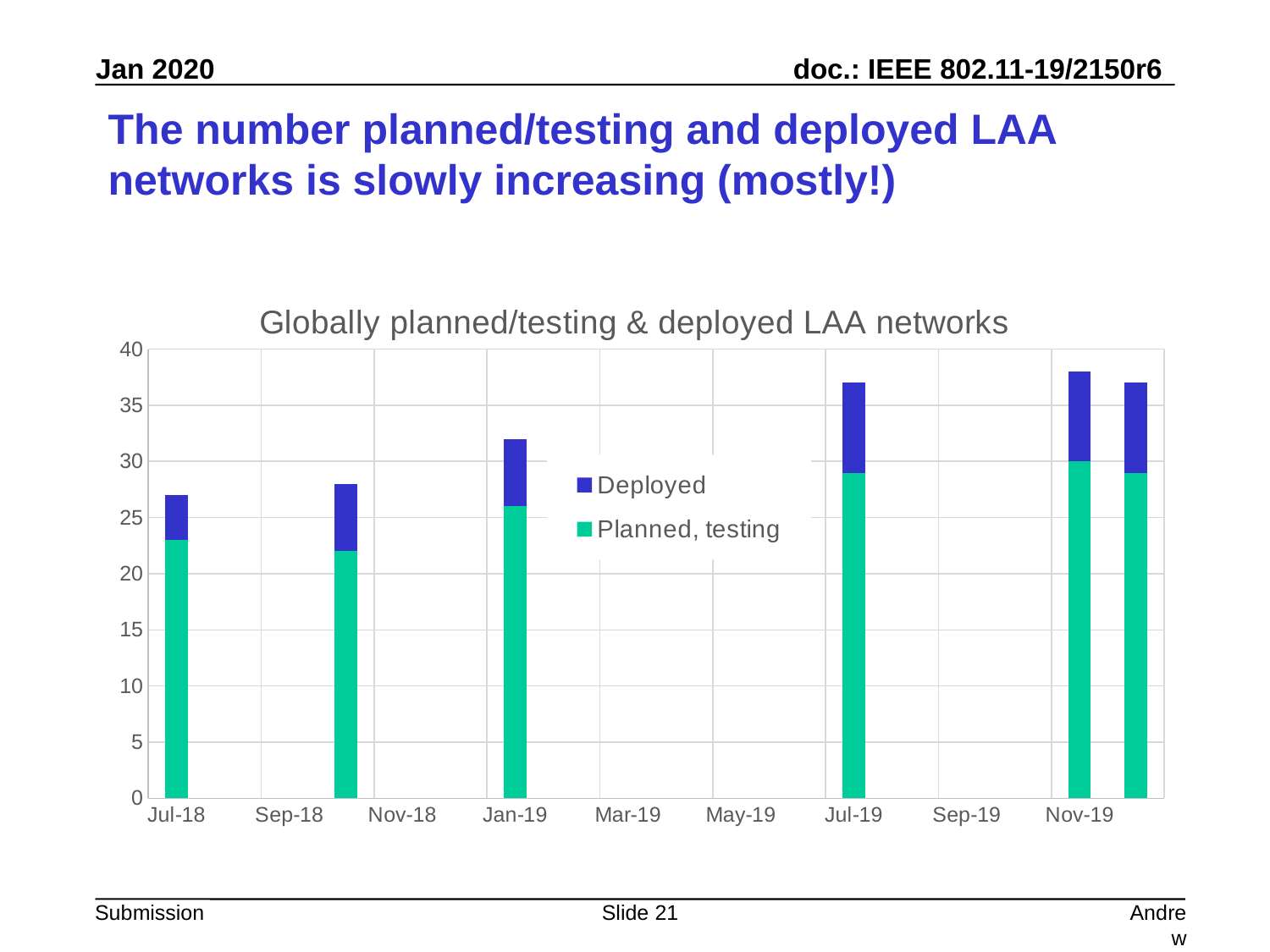
What kind of chart is shown on the slide? stacked bar chart Is the total height of the Jan-19 bar greater or less than 30? greater How many bars are plotted in the chart? 6 How many series does the legend list? 2 Do the total bar heights generally rise or fall from Jul-18 to Nov-19? rise Which series is shown in green? Planned, testing What is the title of the chart? Globally planned/testing & deployed LAA networks Is the total height of the Jul-18 bar greater or less than 25? greater Is the total height of the Jul-19 bar greater or less than 35? greater Which bar is taller in total, Jul-18 or Jul-19? Jul-19